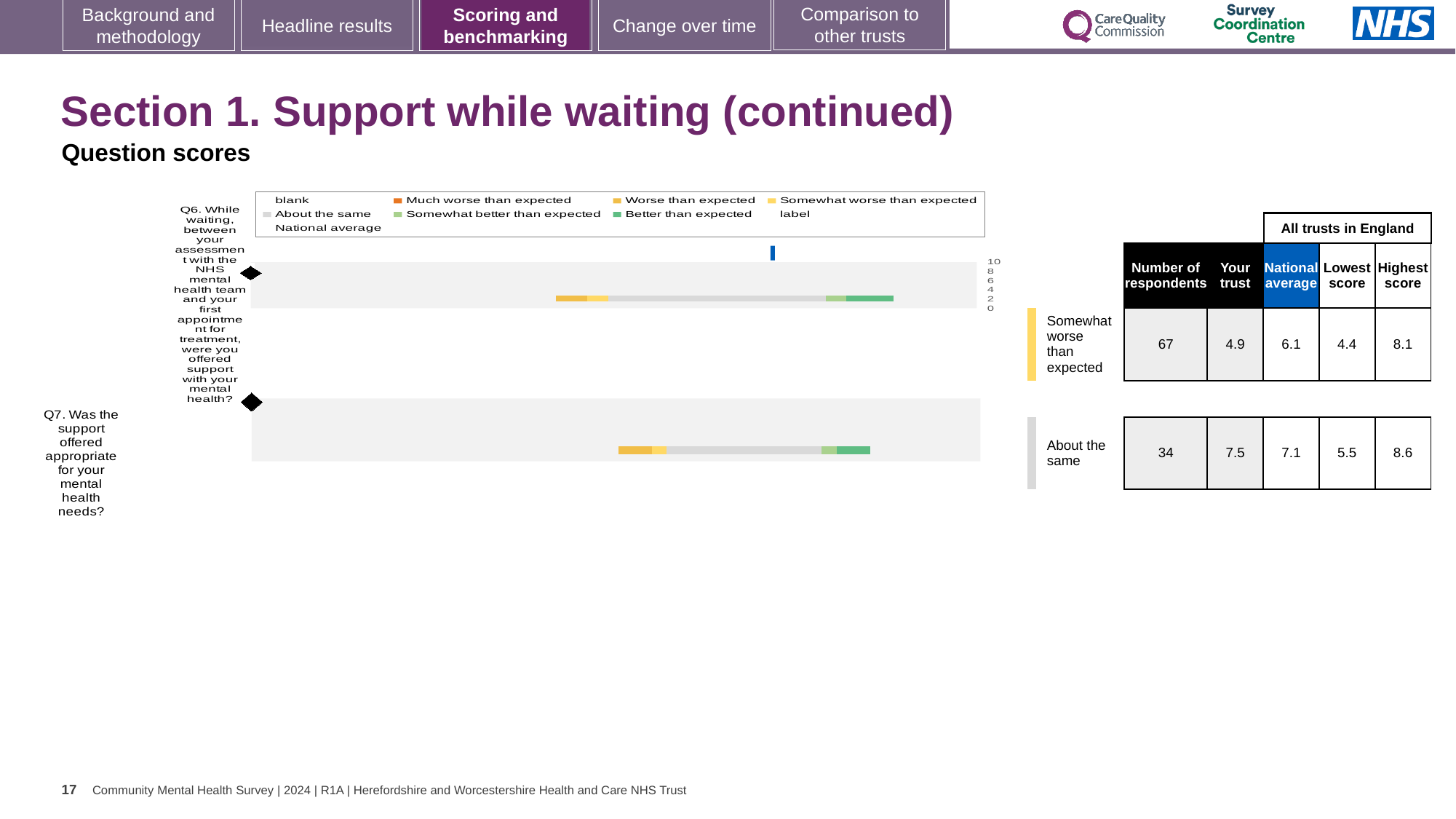
In the legend of the question scores chart, which entry is shown in dark green? Better than expected What is the national average score for Q7? 7.1 What kind of chart is used to show the question scores for Q6 and Q7? bar chart What is the lowest score among all trusts in England for Q7? 5.5 How many respondents are shown for Q6 in the table next to the chart? 67 For Q7, what is the difference between the 'Your trust' score and the national average? 0.4 What is the highest score among all trusts in England for Q7? 8.6 Which benchmark category is Q6 placed in? Somewhat worse than expected How many entries does the legend of the question scores chart list? 9 What is the 'Your trust' score for Q6? 4.9 How many questions are plotted in the question scores chart? 2 For Q6, which is larger: the 'Your trust' score or the national average? National average